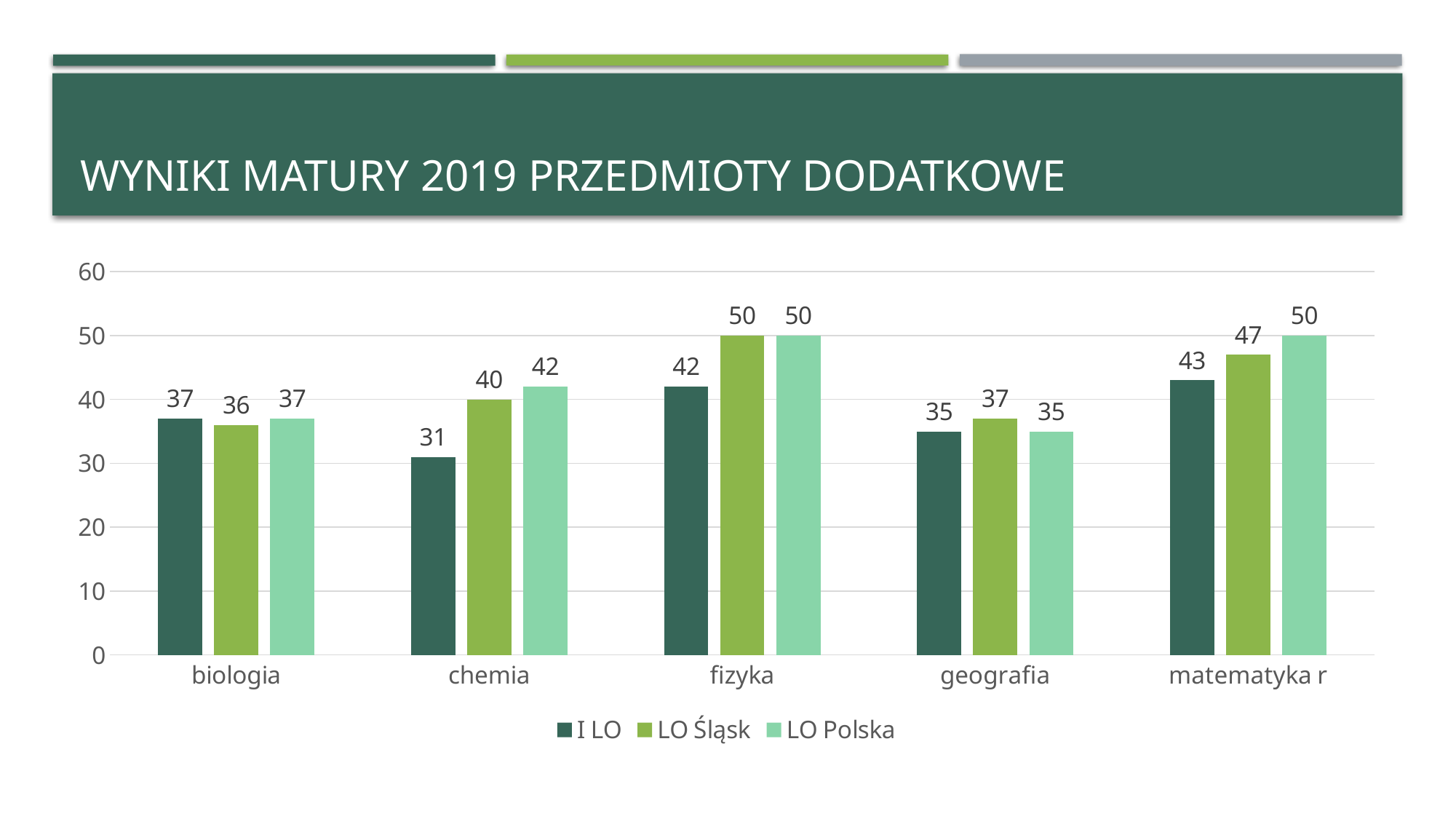
What is the value for LO Polska in matematyka r? 50 What is the difference between LO Polska and I LO in chemia? 11 Which is larger in fizyka: I LO or LO Śląsk? LO Śląsk What kind of chart is shown on the slide? bar chart Is the value for LO Śląsk in matematyka r greater or less than 40? greater What is the value for I LO in chemia? 31 How many series does the legend list? 3 How many categories are shown on the x axis? 5 Which category has the highest value for I LO? matematyka r Which category has the lowest value for I LO? chemia What is the value for LO Śląsk in geografia? 37 What is the title of the slide? WYNIKI MATURY 2019 PRZEDMIOTY DODATKOWE